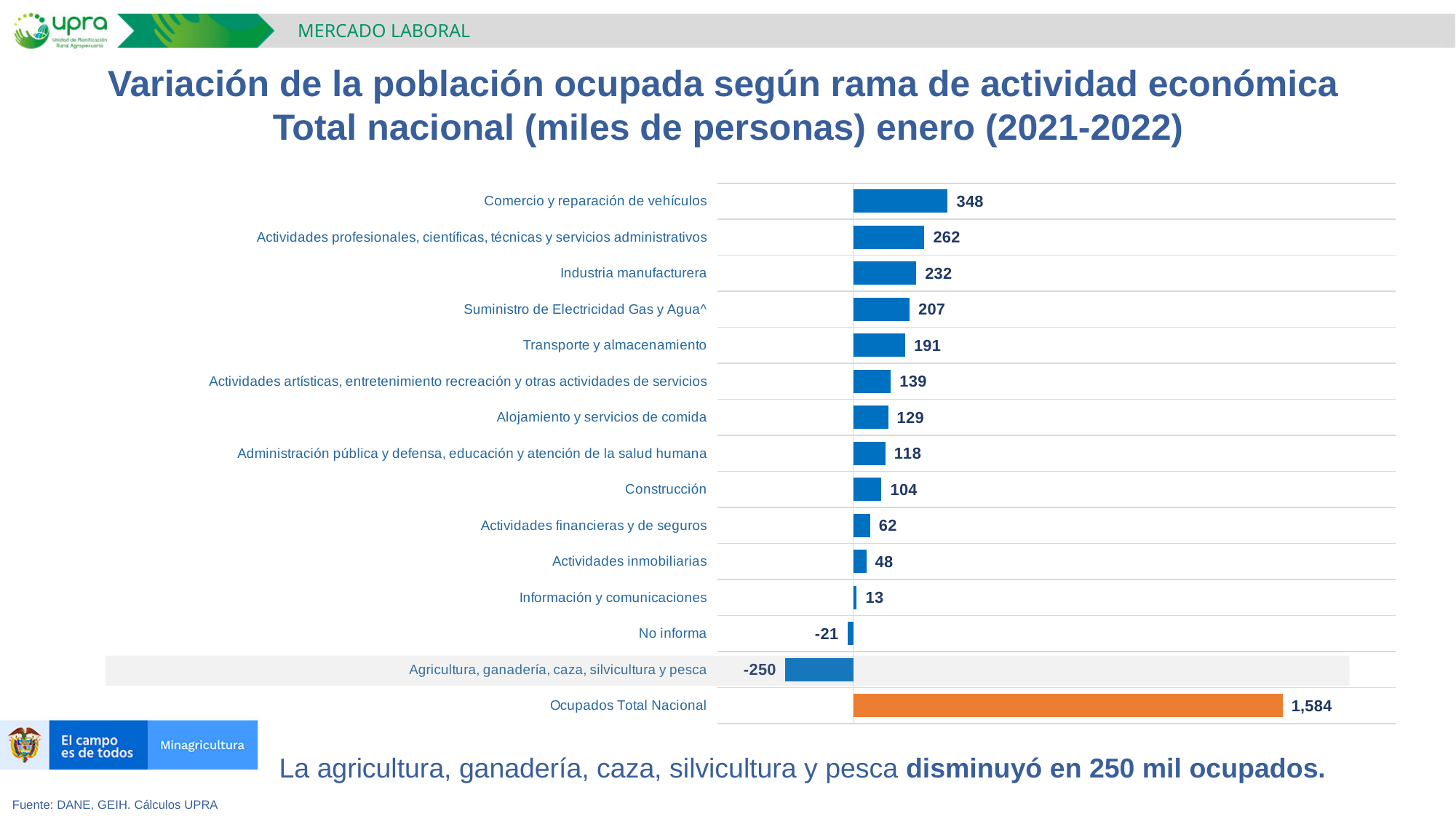
Excluding Ocupados Total Nacional, which category has the highest value? Comercio y reparación de vehículos What is the value for Información y comunicaciones? 13 What is the value for Agricultura, ganadería, caza, silvicultura y pesca? -250 Which category has the lowest value? Agricultura, ganadería, caza, silvicultura y pesca How many categories are shown in the chart? 15 What is the value for Comercio y reparación de vehículos? 348 What is the difference between the values for Comercio y reparación de vehículos and Industria manufacturera? 116 What is the value for No informa? -21 Which is larger, the value for Transporte y almacenamiento or the value for Construcción? Transporte y almacenamiento What is the value for Ocupados Total Nacional? 1,584 Which bar is shown in orange rather than blue? Ocupados Total Nacional What kind of chart is shown on the slide? Bar chart